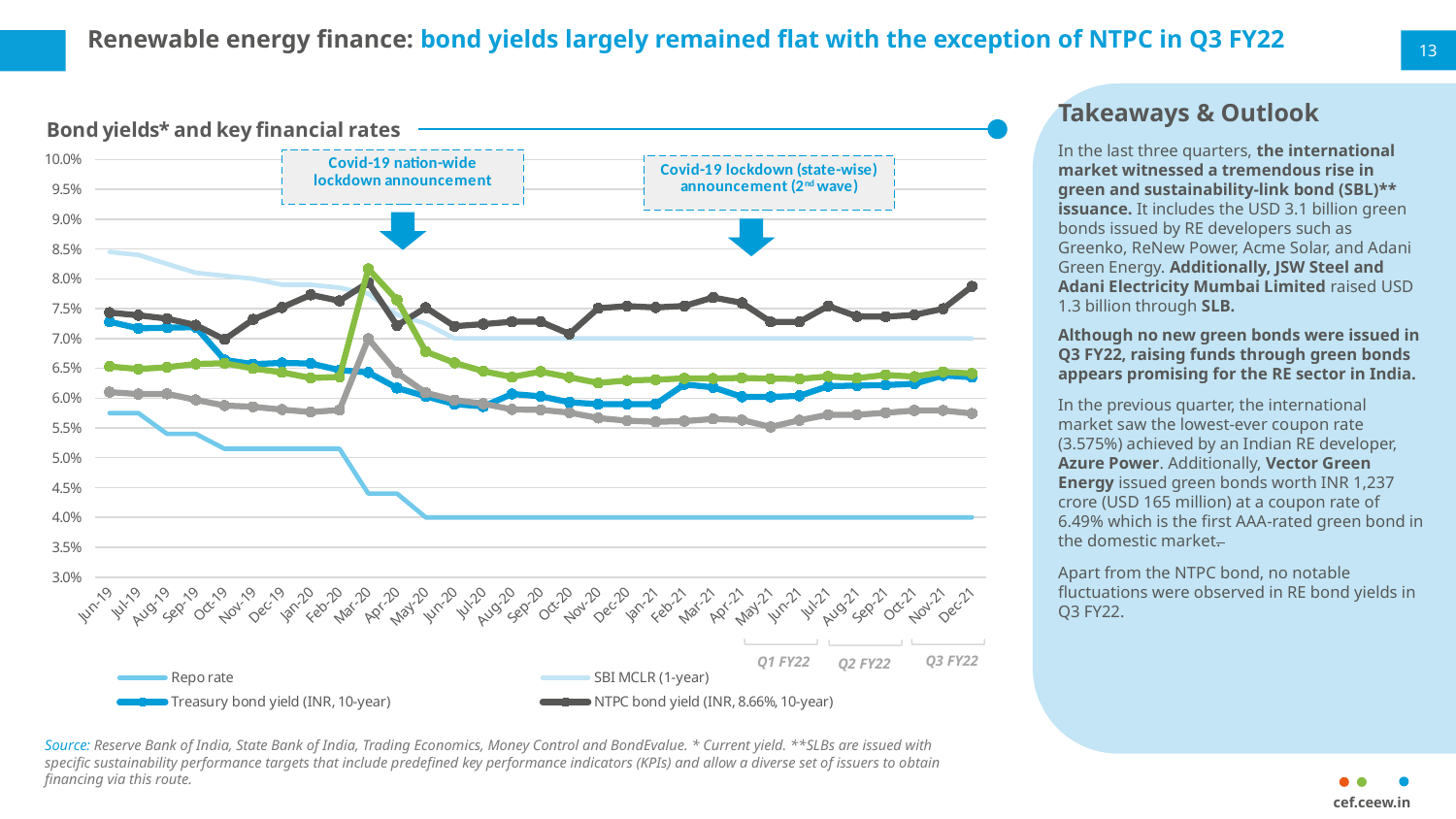
Which series has the lowest value in Dec-21? Repo rate What is the repo rate in Dec-21? 4.0% Is the Treasury bond yield (INR, 10-year) in Dec-21 greater or less than 6.0%? greater Which series has the highest value in Jun-19? SBI MCLR (1-year) What is the title of the chart? Bond yields* and key financial rates What kind of chart is shown on the slide? Line chart Does the repo rate rise or fall from Jun-19 to Dec-21? Fall Is the SBI MCLR (1-year) in Jun-19 greater or less than 8.0%? greater Is the repo rate in Jun-19 greater or less than 5.5%? greater How many monthly points are plotted along the x axis, from Jun-19 to Dec-21? 31 How many series does the chart legend list? 4